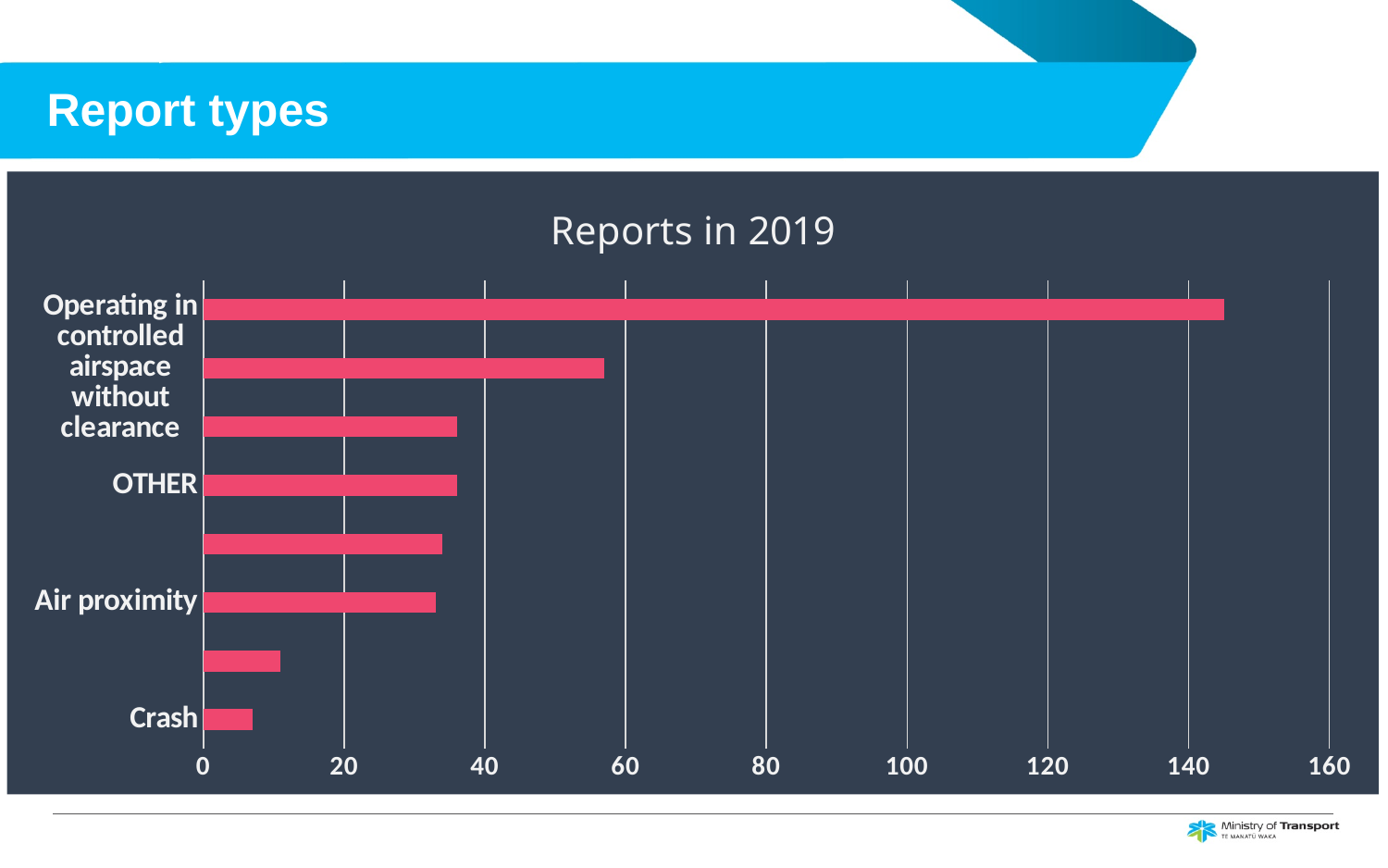
What is the highest value shown on the horizontal axis? 160 Is the value for OTHER greater or less than 40? less Which is larger, the value for Air proximity or the value for Operating in controlled airspace without clearance? Operating in controlled airspace without clearance Is the value for Operating in controlled airspace without clearance greater or less than 140? less How many bars are plotted in the chart? 8 Which labelled report type has the lowest number of reports in 2019? Crash Is the value for Air proximity greater or less than 20? greater What kind of chart is shown on the slide? bar chart What is the title of the chart? Reports in 2019 Which is larger, the value for OTHER or the value for Crash? OTHER